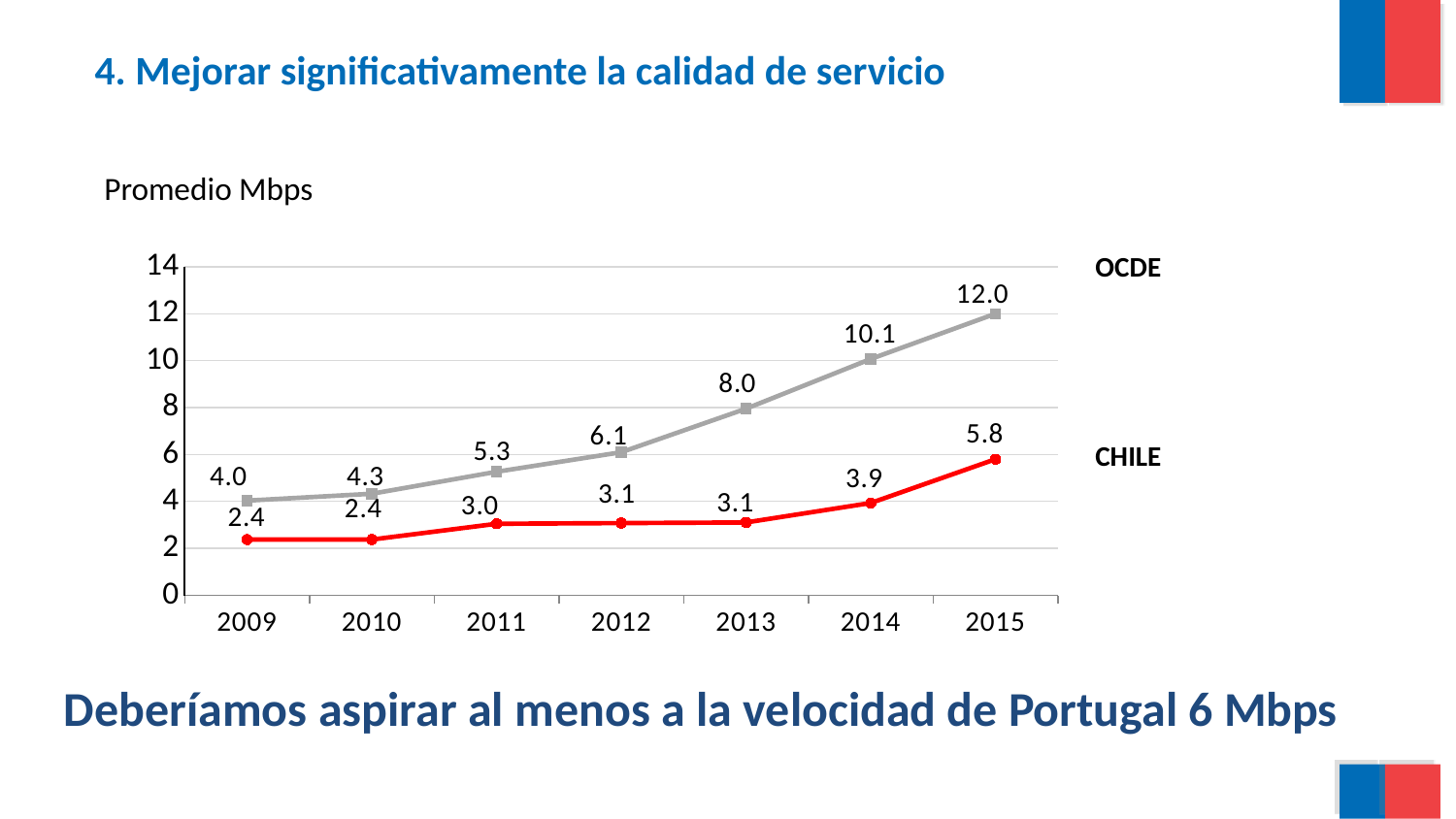
What is the CHILE value in 2012? 3.1 Does the OCDE series rise or fall from 2009 to 2015? rise In which year is the OCDE value lowest? 2009 What is the difference between the OCDE and CHILE values in 2015? 6.2 What is the difference between the OCDE values in 2014 and 2013? 2.1 How many years are shown on the x axis? 7 What kind of chart is shown on the slide? line chart How many series are plotted on the chart? 2 What is the OCDE value in 2009? 4.0 In which year is the CHILE value highest? 2015 What is the OCDE value in 2015? 12.0 Which series has the larger value in 2011, OCDE or CHILE? OCDE